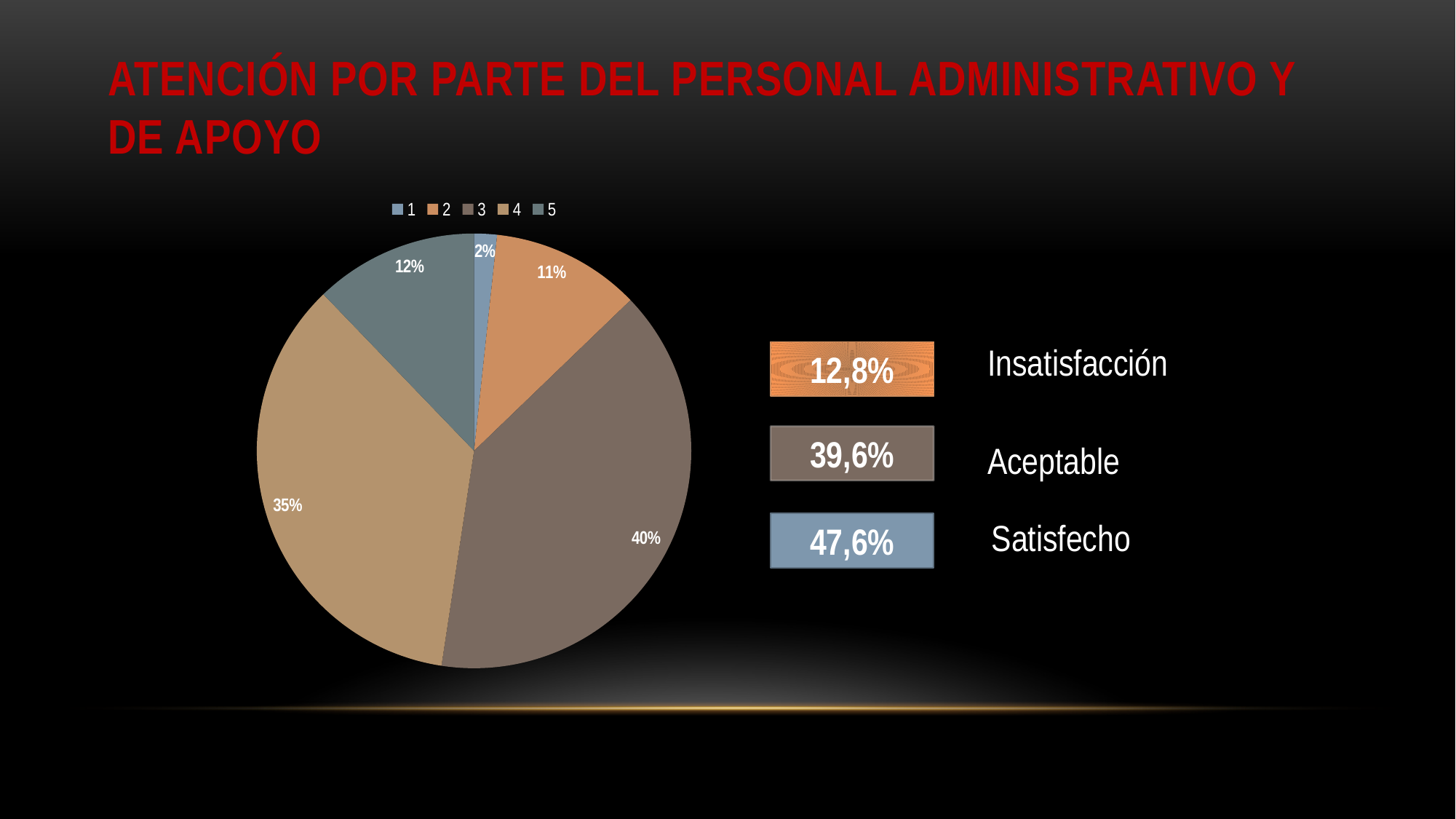
What is the title of the slide containing the pie chart? ATENCIÓN POR PARTE DEL PERSONAL ADMINISTRATIVO Y DE APOYO What percentage does slice 4 represent in the pie chart? 35% How many entries does the legend of the pie chart list? 5 How many slices does the pie chart have? 5 What kind of chart is shown on the slide? pie chart What percentage does slice 5 represent in the pie chart? 12% What percentage does slice 3 represent in the pie chart? 40% What is the difference in percentage points between slice 3 and slice 4 in the pie chart? 5 Which slice is larger in the pie chart, 2 or 5? 5 Which category has the largest slice in the pie chart? 3 What percentage does slice 1 represent in the pie chart? 2% Which category has the smallest slice in the pie chart? 1